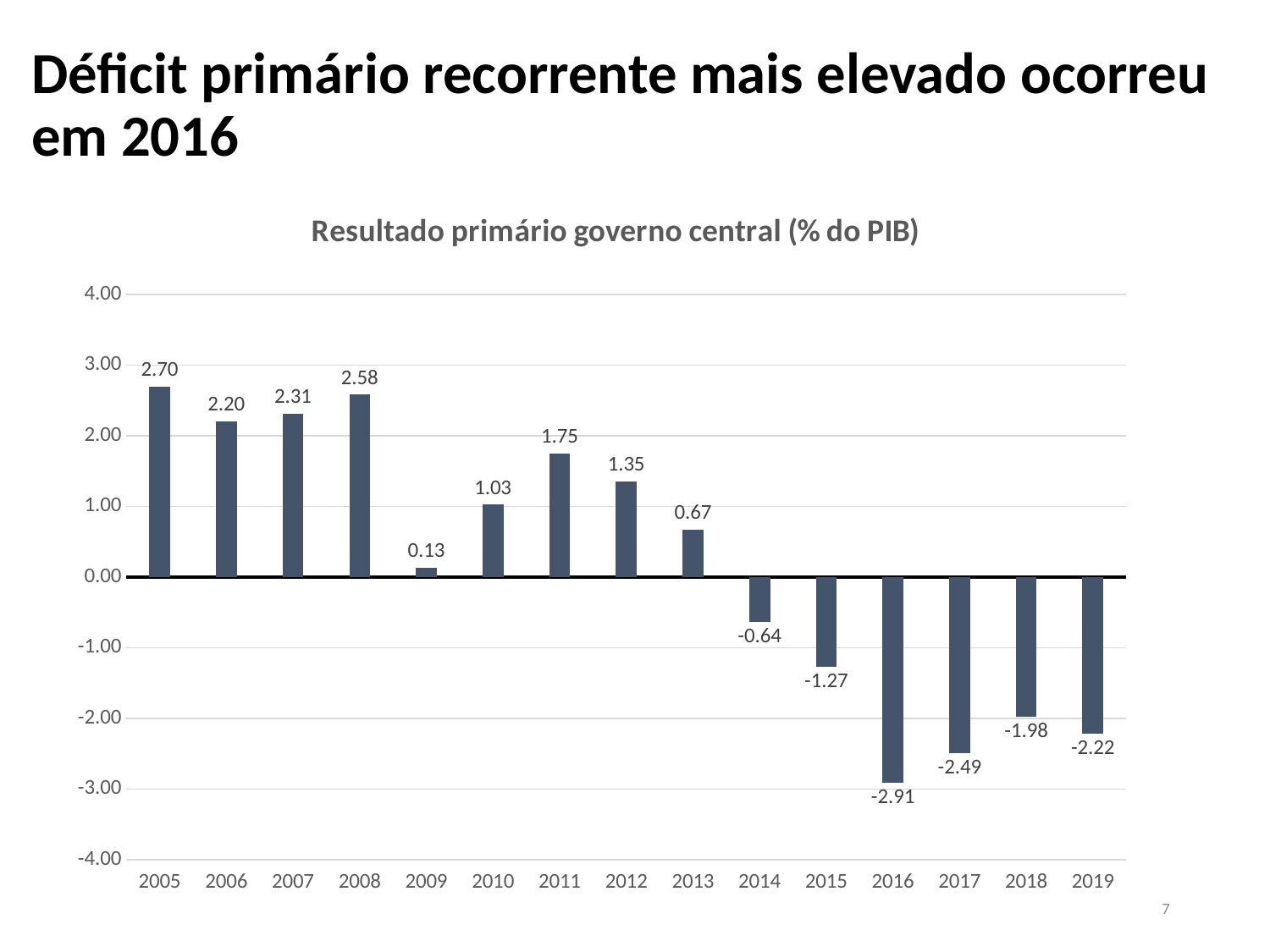
Which is larger, the value for 2011 or the value for 2012? 2011 What is the difference between the values for 2008 and 2007? 0.27 Is the value for 2017 greater or less than -2.00? less Which year has the highest value? 2005 What is the value for 2009? 0.13 Which year has the lowest value? 2016 Do the values generally rise or fall from 2005 to 2016? fall How many years are shown on the x axis? 15 What is the value for 2016? -2.91 What kind of chart is this? bar chart What is the title of the chart? Resultado primário governo central (% do PIB) What is the value for 2005? 2.70